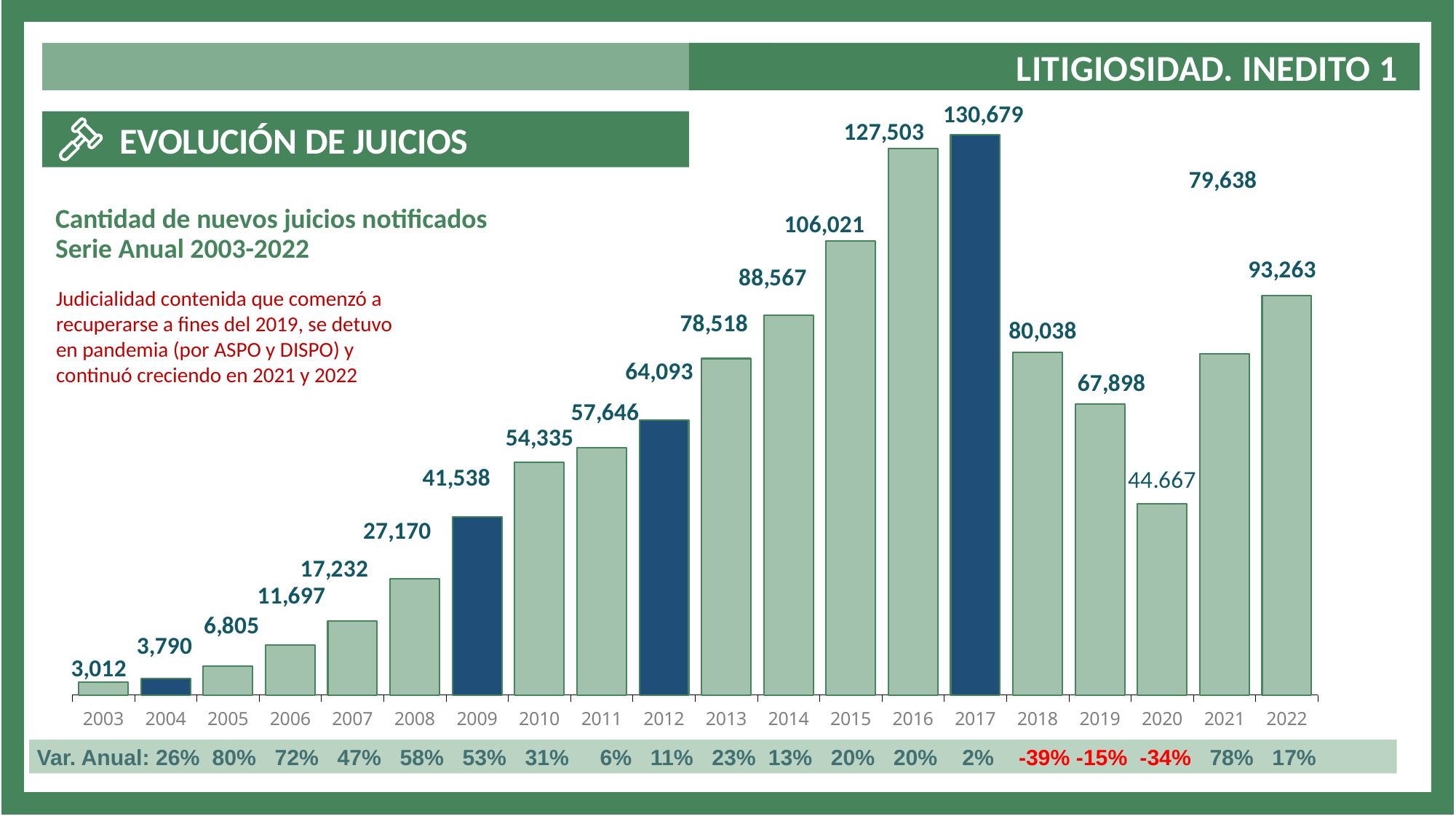
What annual variation (Var. Anual) is shown for 2018? -39% What is the difference between the values for 2017 and 2016? 3,176 Which year has the highest number of new lawsuits? 2017 Which year has the lowest number of new lawsuits? 2003 Do the values rise or fall from 2003 to 2017? Rise What kind of chart is shown on the slide? Bar chart Which is larger, the value for 2018 or the value for 2021? 2018 How many years (bars) are plotted in the chart? 20 What is the value shown for 2009? 41,538 What is the value shown for 2017? 130,679 What is the value shown for 2022? 93,263 What is the difference between the values for 2022 and 2021? 13,625